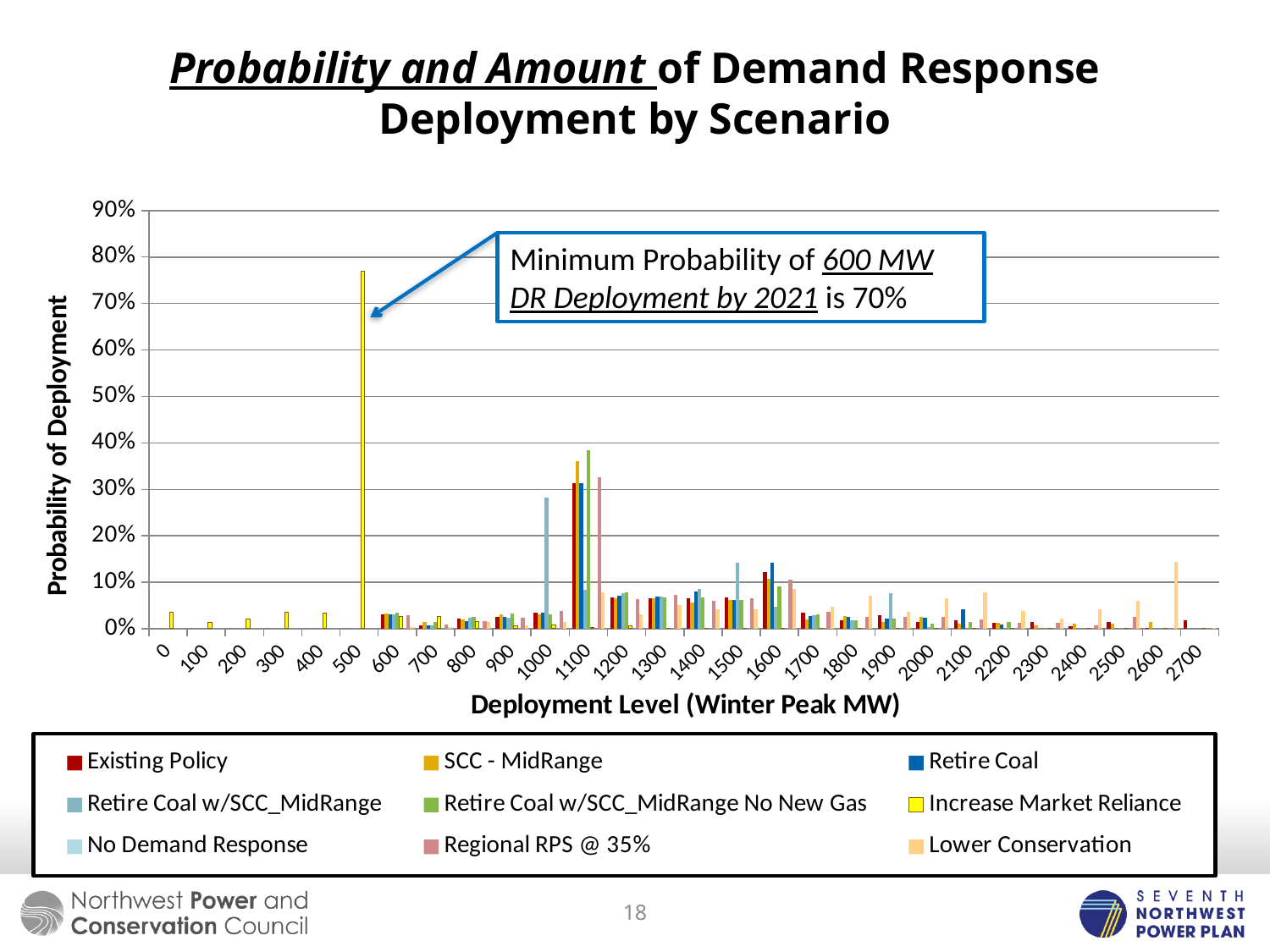
How many series does the legend list? 9 Is the value for No Demand Response at deployment level 1000 greater or less than 20%? less Is the value for Lower Conservation at deployment level 2600 greater or less than 10%? greater How many deployment level categories are shown on the x axis? 28 What is the label of the x axis? Deployment Level (Winter Peak MW) Which is larger: the Increase Market Reliance bar at 500 or the Retire Coal w/SCC_MidRange No New Gas bar at 1100? Increase Market Reliance bar at 500 At which deployment level does the tallest bar in the chart appear? 500 Is the value for Retire Coal w/SCC_MidRange No New Gas at deployment level 1100 greater or less than 30%? greater What kind of chart is shown on the slide? bar chart Which series has the tallest bar in the chart? Increase Market Reliance What is the label of the y axis? Probability of Deployment